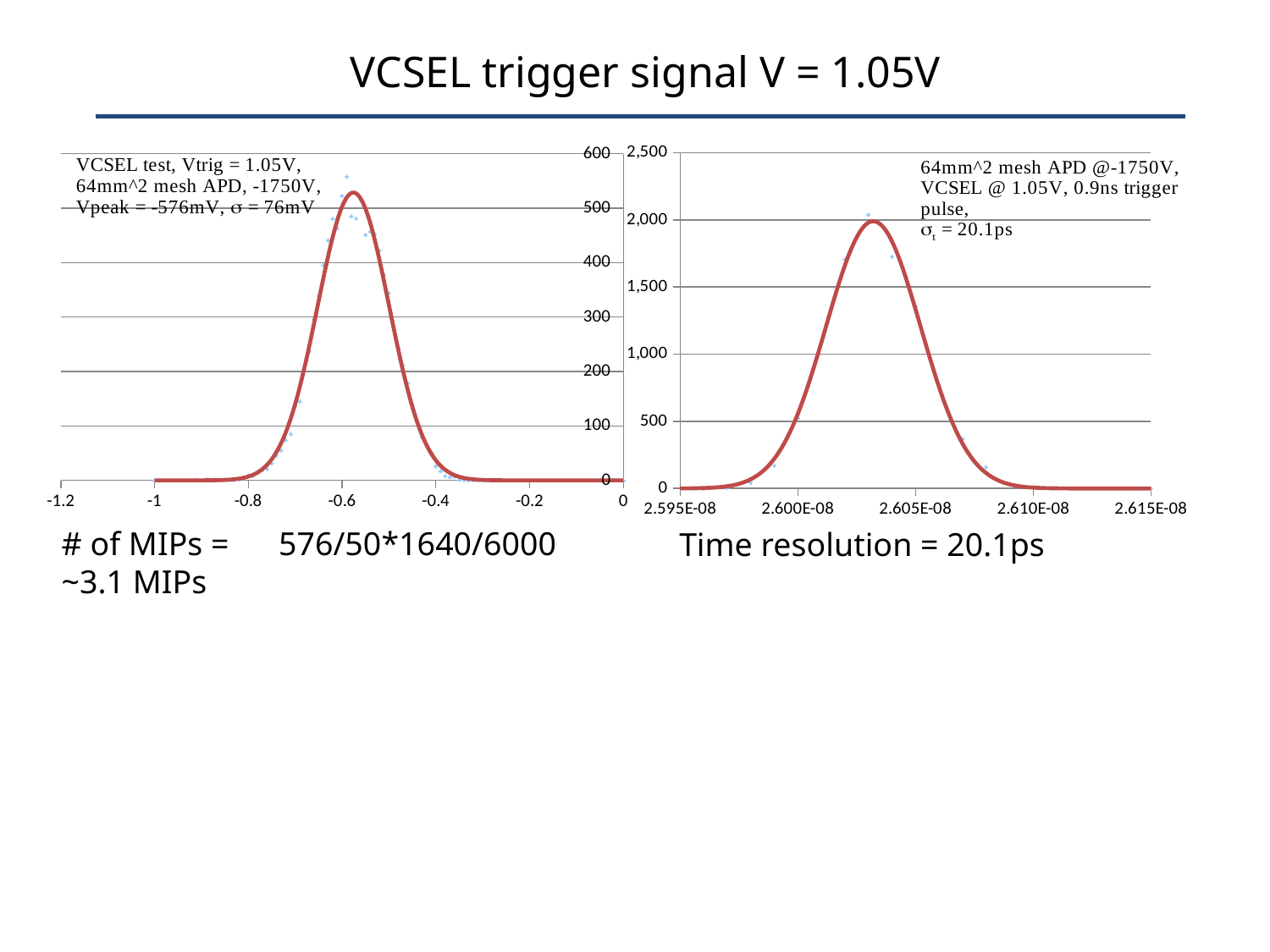
On the right chart, do the values rise or fall as x goes from 2.605E-08 to 2.610E-08? fall On the right chart, is the peak of the fitted curve greater or less than 1,500? greater According to the annotation on the left chart, what is Vpeak? -576mV What kind of chart is the left chart on the slide? scatter chart with a fitted curve What kind of chart is the right chart on the slide? scatter chart with a fitted curve According to the annotation on the right chart, what is the time resolution σt? 20.1ps On the left chart, do the values rise or fall as x goes from -0.8 to -0.6? rise On the right chart, is the value at x = 2.610E-08 greater or less than 500? less On the right chart, which x value has the larger y value: 2.600E-08 or 2.605E-08? 2.605E-08 On the left chart, which x value has the larger y value: -0.6 or -0.4? -0.6 On the left chart, is the value at x = -0.8 greater or less than 100? less